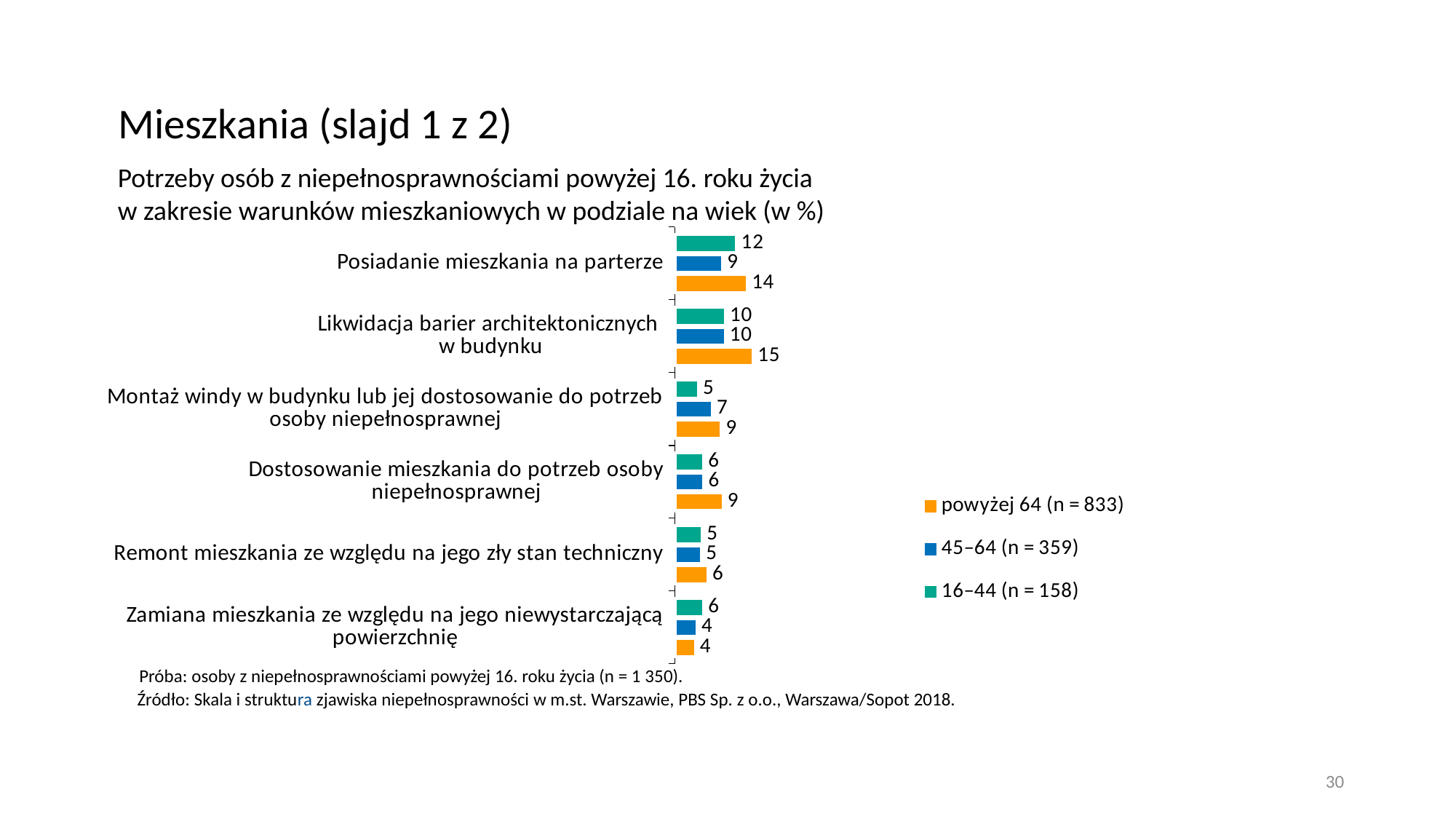
How many categories are shown on the chart? 6 What is the value for '45–64 (n = 359)' in the category 'Montaż windy w budynku lub jej dostosowanie do potrzeb osoby niepełnosprawnej'? 7 What kind of chart is shown on the slide? Bar chart How many series does the legend list? 3 Which category has the highest value for the 'powyżej 64 (n = 833)' series? Likwidacja barier architektonicznych w budynku Which category has the lowest value for the '45–64 (n = 359)' series? Zamiana mieszkania ze względu na jego niewystarczającą powierzchnię What is the value for '16–44 (n = 158)' in the category 'Posiadanie mieszkania na parterze'? 12 What is the sample size shown in the legend for the '16–44' series? n = 158 What is the value for 'powyżej 64 (n = 833)' in the category 'Likwidacja barier architektonicznych w budynku'? 15 For 'Zamiana mieszkania ze względu na jego niewystarczającą powierzchnię', which series has the larger value: '16–44 (n = 158)' or 'powyżej 64 (n = 833)'? 16–44 (n = 158) What colour represents the 'powyżej 64 (n = 833)' series? Orange What is the difference between the 'powyżej 64 (n = 833)' and '45–64 (n = 359)' values for 'Posiadanie mieszkania na parterze'? 5